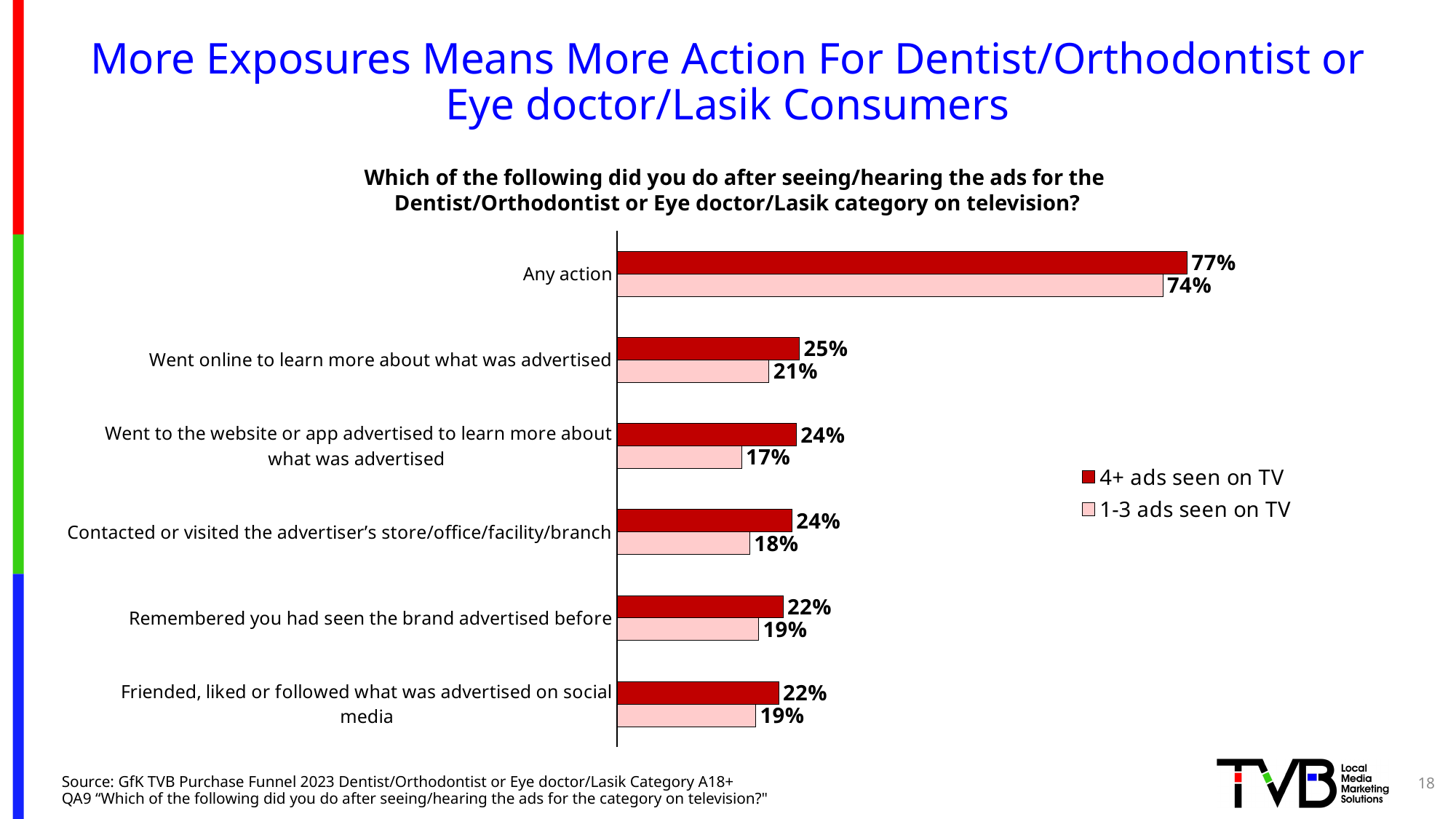
For 'Remembered you had seen the brand advertised before', which series has the larger value: 4+ ads seen on TV or 1-3 ads seen on TV? 4+ ads seen on TV Which category has the lowest value for the 1-3 ads seen on TV series? Went to the website or app advertised to learn more about what was advertised What kind of chart is shown on the slide? Bar chart How many categories are shown on the chart? 6 What percentage of consumers who saw 4+ ads on TV took any action? 77% Which category has the highest value for the 1-3 ads seen on TV series? Any action What is the value for 'Contacted or visited the advertiser's store/office/facility/branch' for the 4+ ads seen on TV series? 24% How many series does the legend list? 2 Which series is shown in dark red in the legend? 4+ ads seen on TV What is the difference between the 4+ ads and 1-3 ads values for 'Any action'? 3 percentage points What is the difference between the 4+ ads and 1-3 ads values for 'Went to the website or app advertised to learn more about what was advertised'? 7 percentage points What is the value for 'Went online to learn more about what was advertised' among those who saw 1-3 ads on TV? 21%